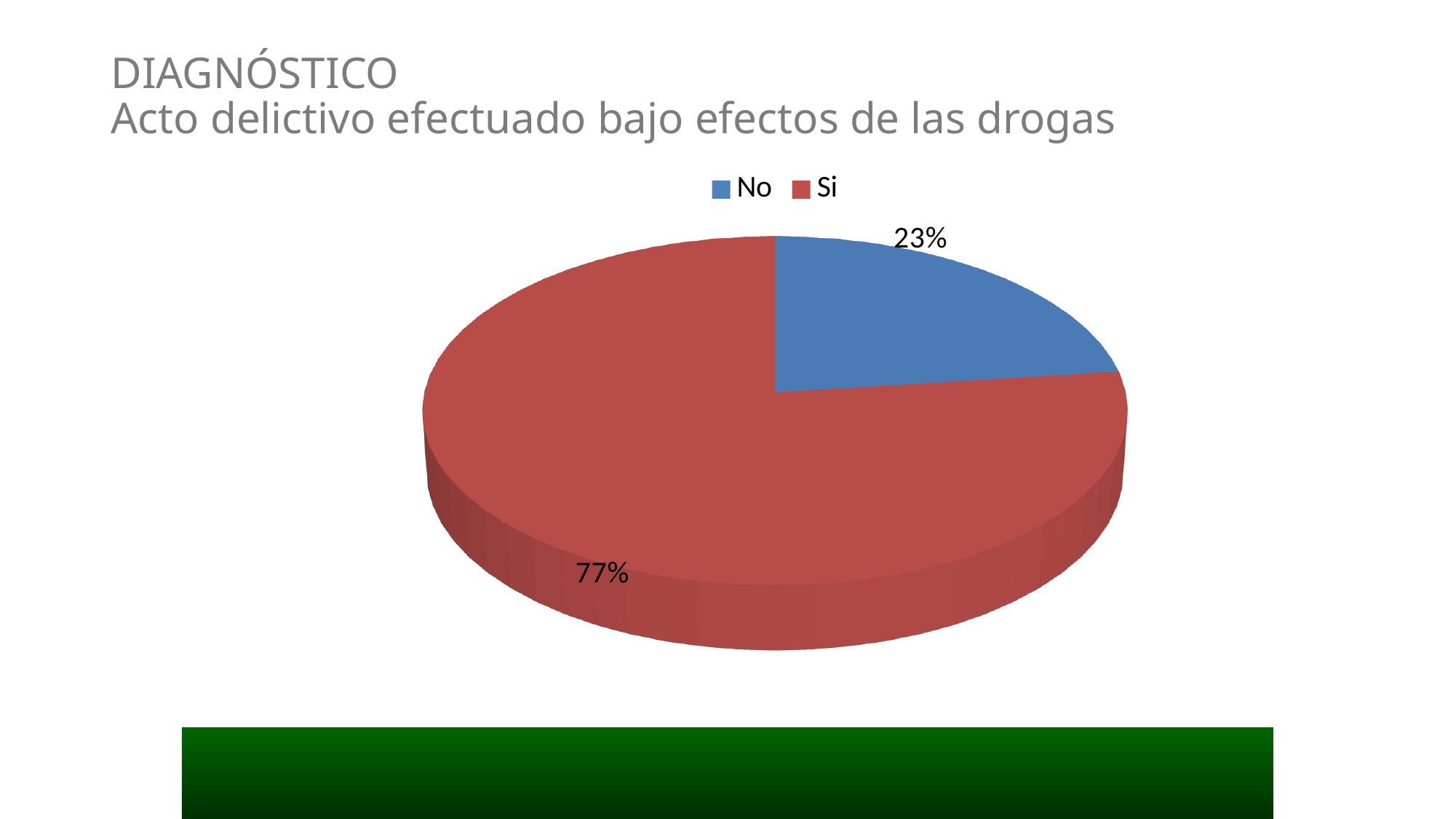
Which category has the smallest slice of the pie? No How many categories does the pie chart show? 2 Which is larger, the "Si" slice or the "No" slice? Si What share of the pie does the "No" slice represent? 23% What colour is the "No" slice? blue What is the difference in percentage points between the "Si" and "No" slices? 54 What share of the pie does the "Si" slice represent? 77% Which category has the largest slice of the pie? Si How many entries does the legend list? 2 What colour is the "Si" slice? red What kind of chart is shown on the slide? pie chart